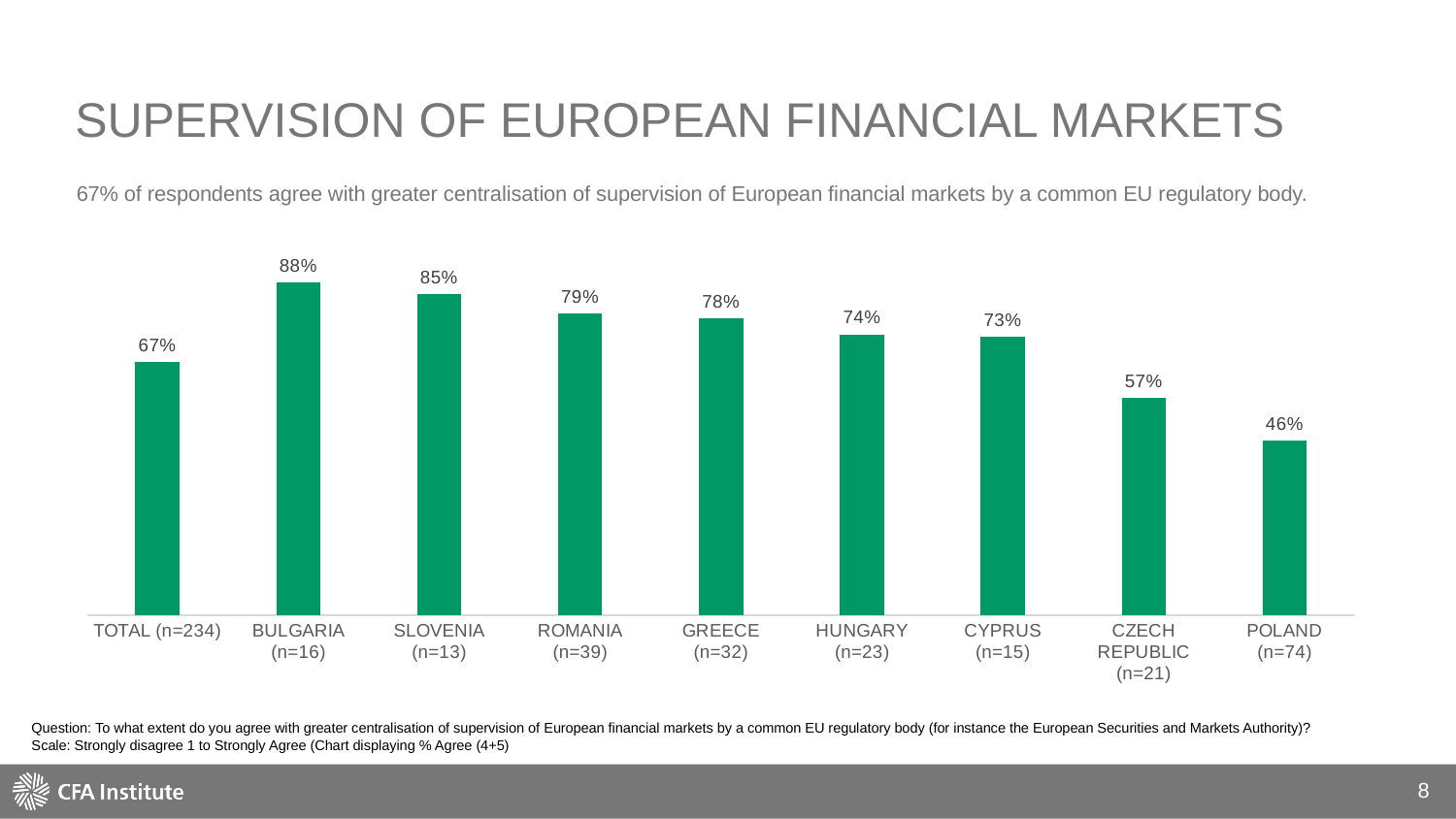
What percentage of respondents in Bulgaria agree with greater centralisation of supervision? 88% How many bars are shown in the chart? 9 What is the sample size (n) shown for Romania? 39 What is the value shown for the Total (n=234) bar? 67% What is the value shown for Poland? 46% What is the difference between the values for Slovenia and Czech Republic? 28% Which country has the lowest percentage of agreement? Poland What is the value shown for Hungary? 74% What is the difference between the values for Bulgaria and Poland? 42% Which country has the highest percentage of agreement? Bulgaria Which has a higher value, Greece or Cyprus? Greece What type of chart is shown on the slide? Bar chart